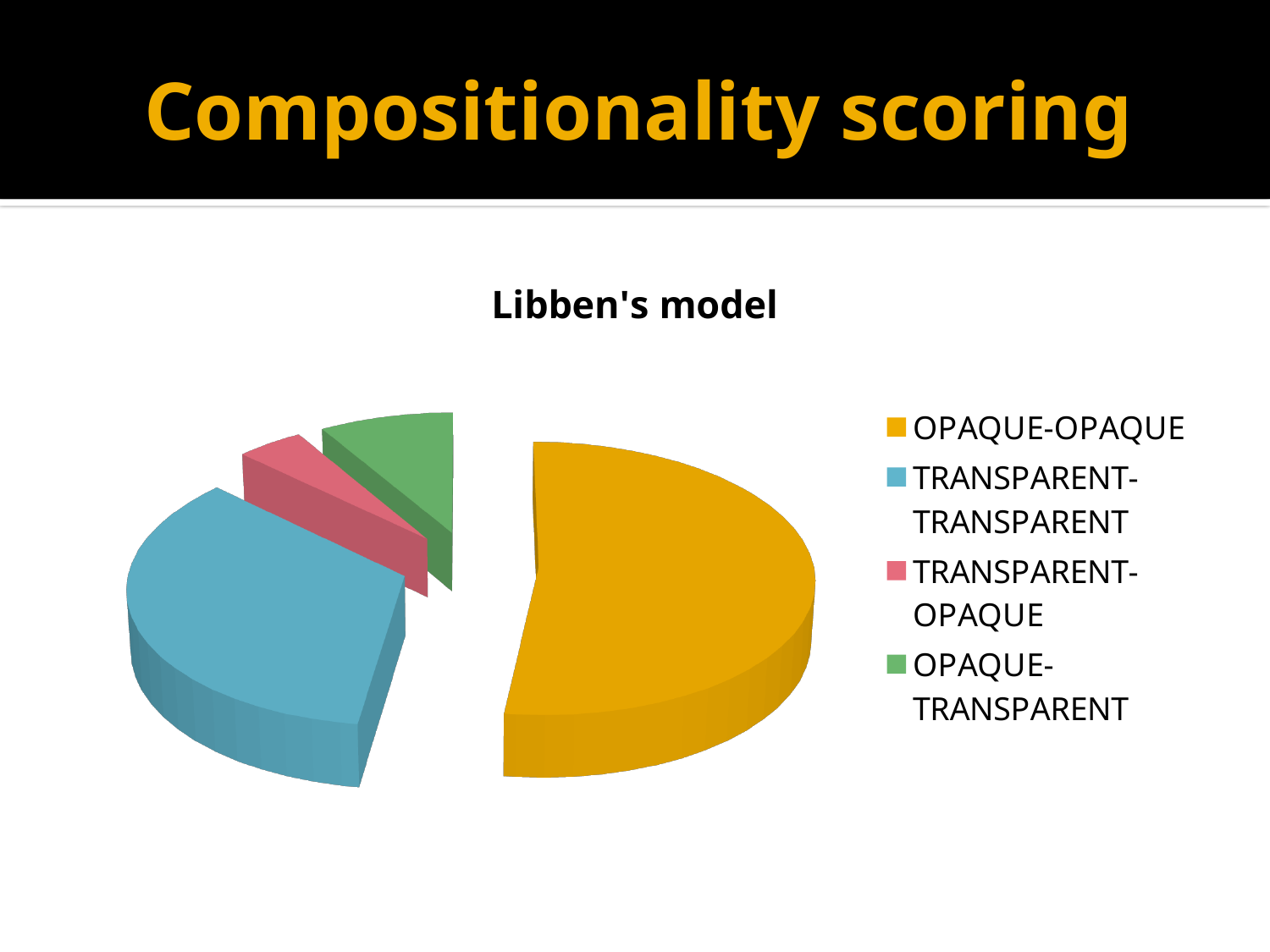
How many slices does the pie chart have? 4 How many entries does the legend list? 4 Which category has the largest slice of the pie? OPAQUE-OPAQUE What kind of chart is shown on the slide? pie chart Which category is the second-largest slice of the pie? TRANSPARENT-TRANSPARENT Which slice is larger, TRANSPARENT-OPAQUE or OPAQUE-OPAQUE? OPAQUE-OPAQUE What is the title of the chart? Libben's model Which slice is larger, TRANSPARENT-TRANSPARENT or OPAQUE-TRANSPARENT? TRANSPARENT-TRANSPARENT Which slice is larger, OPAQUE-OPAQUE or TRANSPARENT-TRANSPARENT? OPAQUE-OPAQUE What colour represents OPAQUE-OPAQUE in the pie chart? yellow